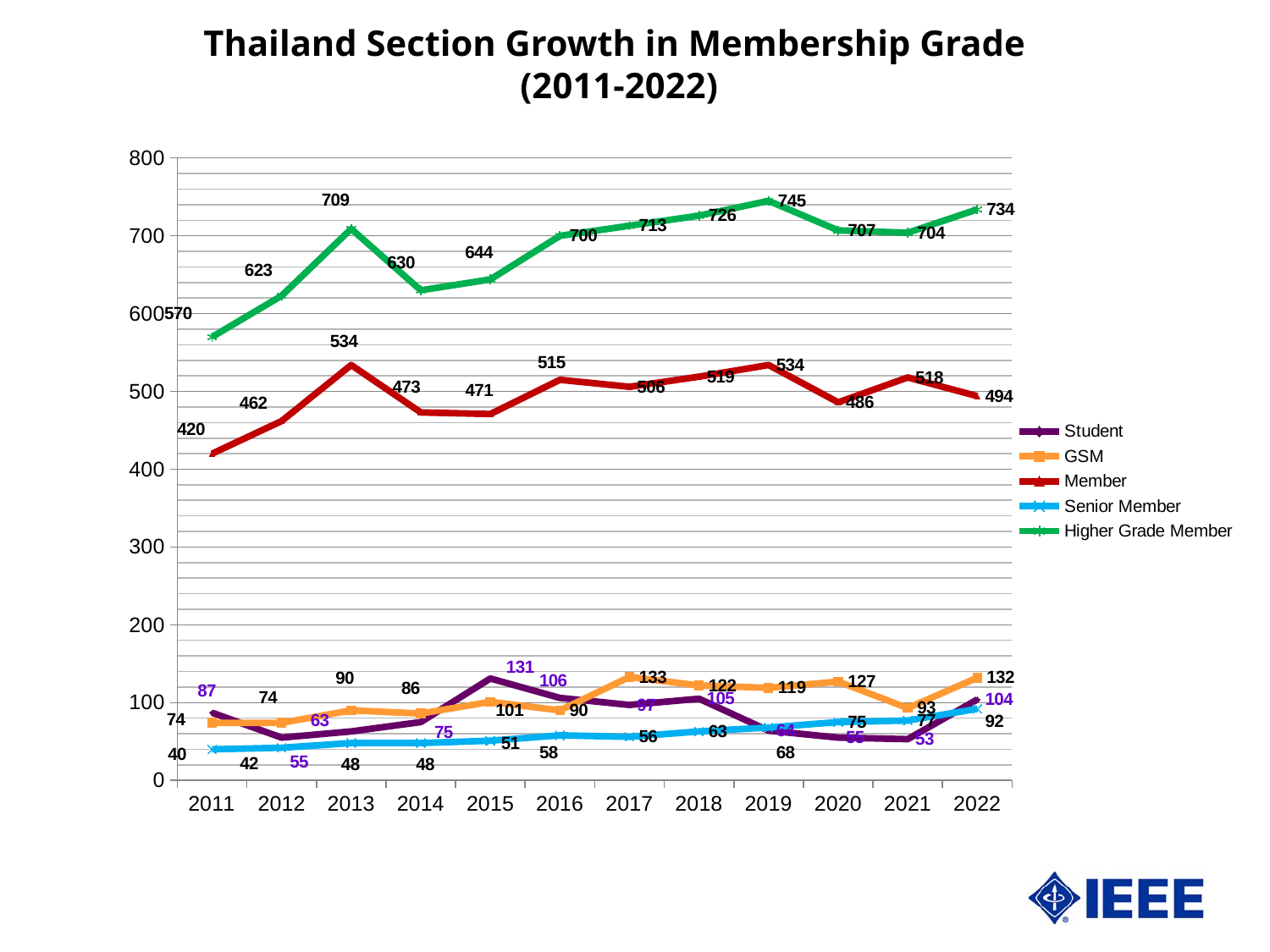
What is the value for Member in 2013? 534 How many series does the legend list? 5 What kind of chart is shown on the slide? line chart Which year has the larger Member value, 2016 or 2017? 2016 What is the value for Higher Grade Member in 2019? 745 Does the Senior Member series generally rise or fall from 2011 to 2022? rise What is the value for GSM in 2017? 133 How many years are shown on the x axis? 12 Is the value for Member in 2019 greater or less than 500? greater In which year is the Higher Grade Member value highest? 2019 What is the difference between the Higher Grade Member values in 2022 and 2011? 164 In which year is the Member value lowest? 2011